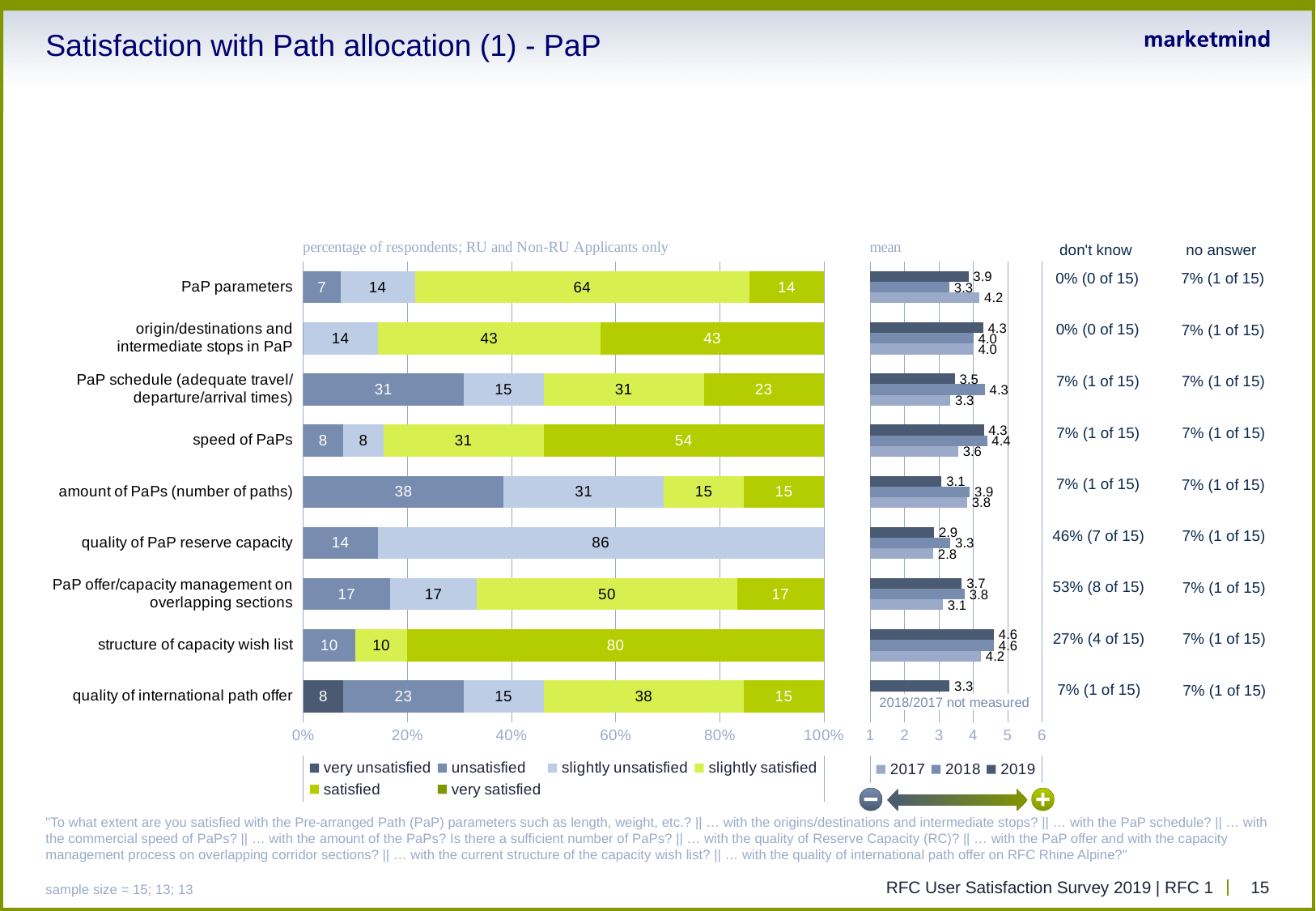
In the mean chart, what is the 2019 mean for 'structure of capacity wish list'? 4.6 How many series does the legend of the left percentage chart list? 6 How many categories (rows) are shown in the left percentage chart? 9 In the left percentage chart, what value is printed on the largest segment for 'structure of capacity wish list'? 80 In the mean chart, what is the difference between the 2018 mean (4.3) and the 2019 mean (3.5) for 'PaP schedule (adequate travel/departure/arrival times)'? 0.8 In the mean chart, which category has the lowest 2019 mean? quality of PaP reserve capacity In the left percentage chart, what is the 'unsatisfied' value for 'amount of PaPs (number of paths)'? 38 How many series does the legend of the mean chart list? 3 In the left percentage chart, what value is printed on the largest segment for 'quality of PaP reserve capacity'? 86 In the mean chart, which has the higher 2019 mean: 'speed of PaPs' or 'amount of PaPs (number of paths)'? speed of PaPs What kind of chart is the left chart showing the percentage of respondents? bar chart In the mean chart, what is the 2017 mean for 'PaP parameters'? 4.2